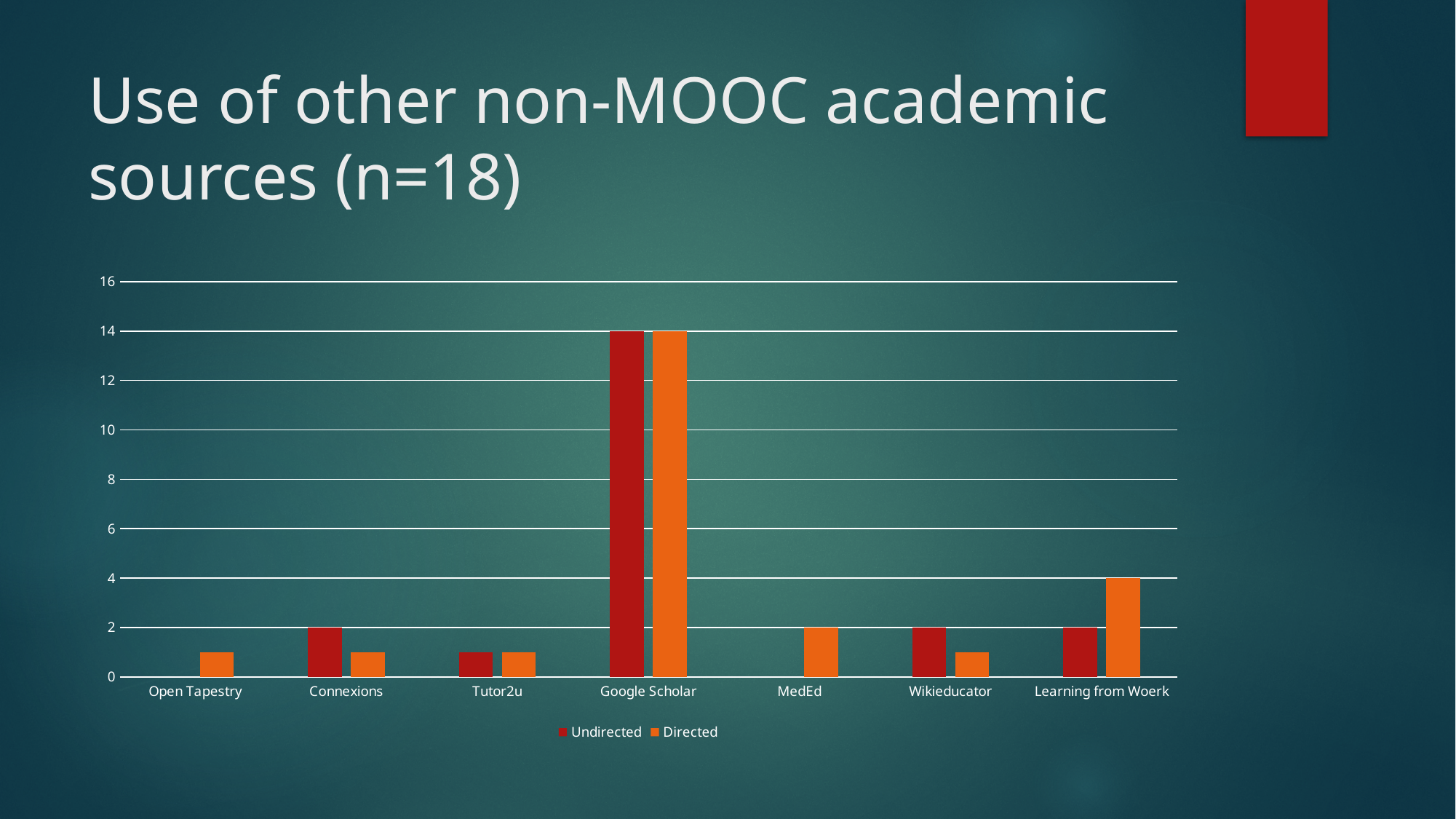
What is the Directed value for MedEd? 2 What is the Undirected value for Connexions? 2 What kind of chart is shown on the slide? bar chart Which category has the highest Undirected value? Google Scholar What is the difference between the Directed value for Learning from Woerk and the Directed value for MedEd? 2 How many series does the legend list? 2 Which category has the highest Directed value? Google Scholar What is the Undirected value for Google Scholar? 14 What is the Directed value for Learning from Woerk? 4 For Learning from Woerk, which is larger, the Undirected or the Directed value? Directed Is the Directed value for Open Tapestry greater or less than 2? less How many categories are shown on the x axis? 7